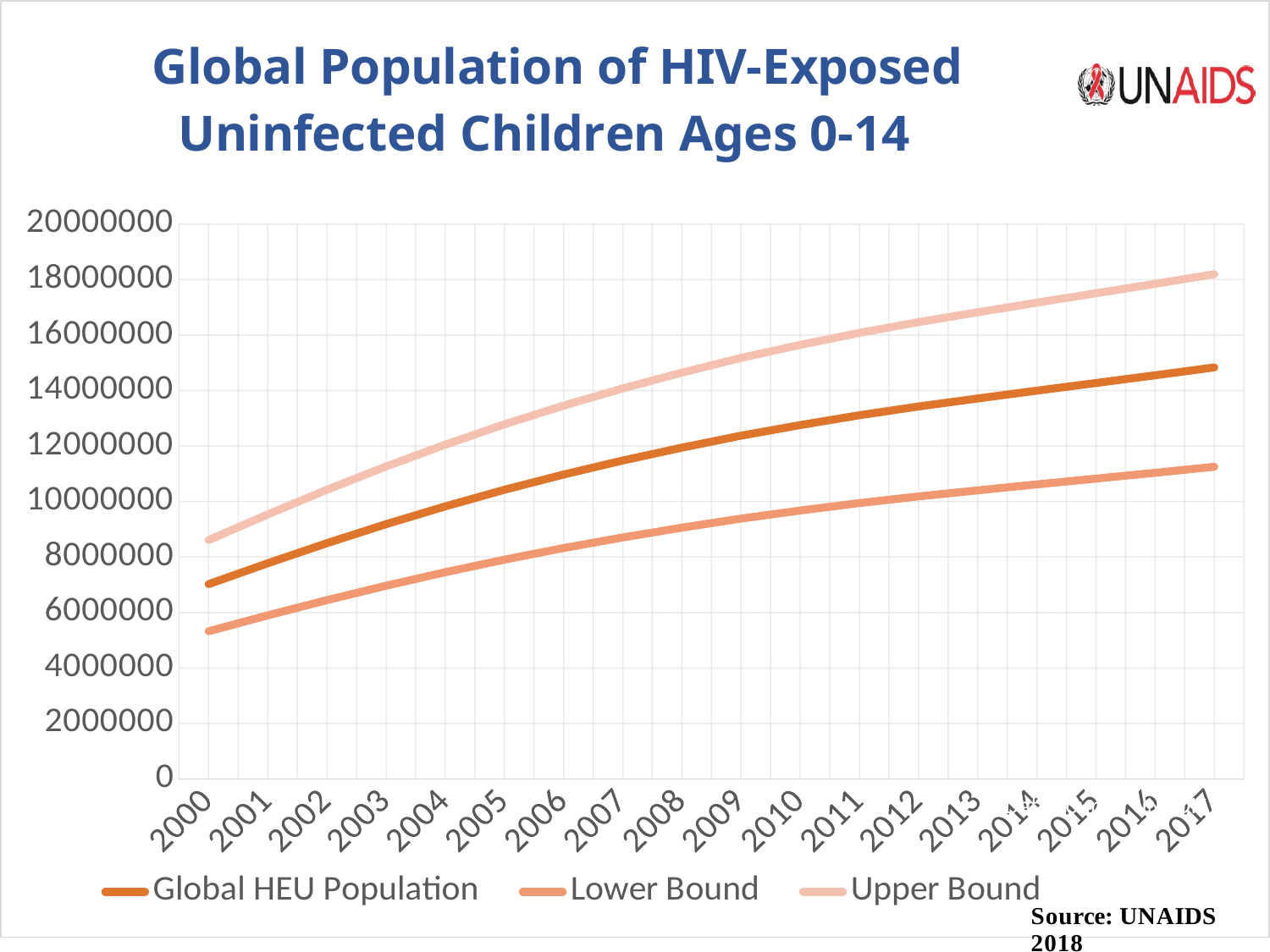
Is the value for Upper Bound in 2017 greater or less than 16000000? greater In which year is the Global HEU Population highest? 2017 What kind of chart is shown on the slide? Line chart In which year is the Lower Bound lowest? 2000 In 2010, which is larger: the Upper Bound or the Lower Bound? Upper Bound Does the Global HEU Population rise or fall from 2000 to 2017? Rise What is the title of the chart? Global Population of HIV-Exposed Uninfected Children Ages 0-14 How many years are plotted along the x axis? 18 Is the value for Lower Bound in 2000 greater or less than 6000000? less Is the value for Global HEU Population in 2000 greater or less than 8000000? less How many series does the legend list? 3